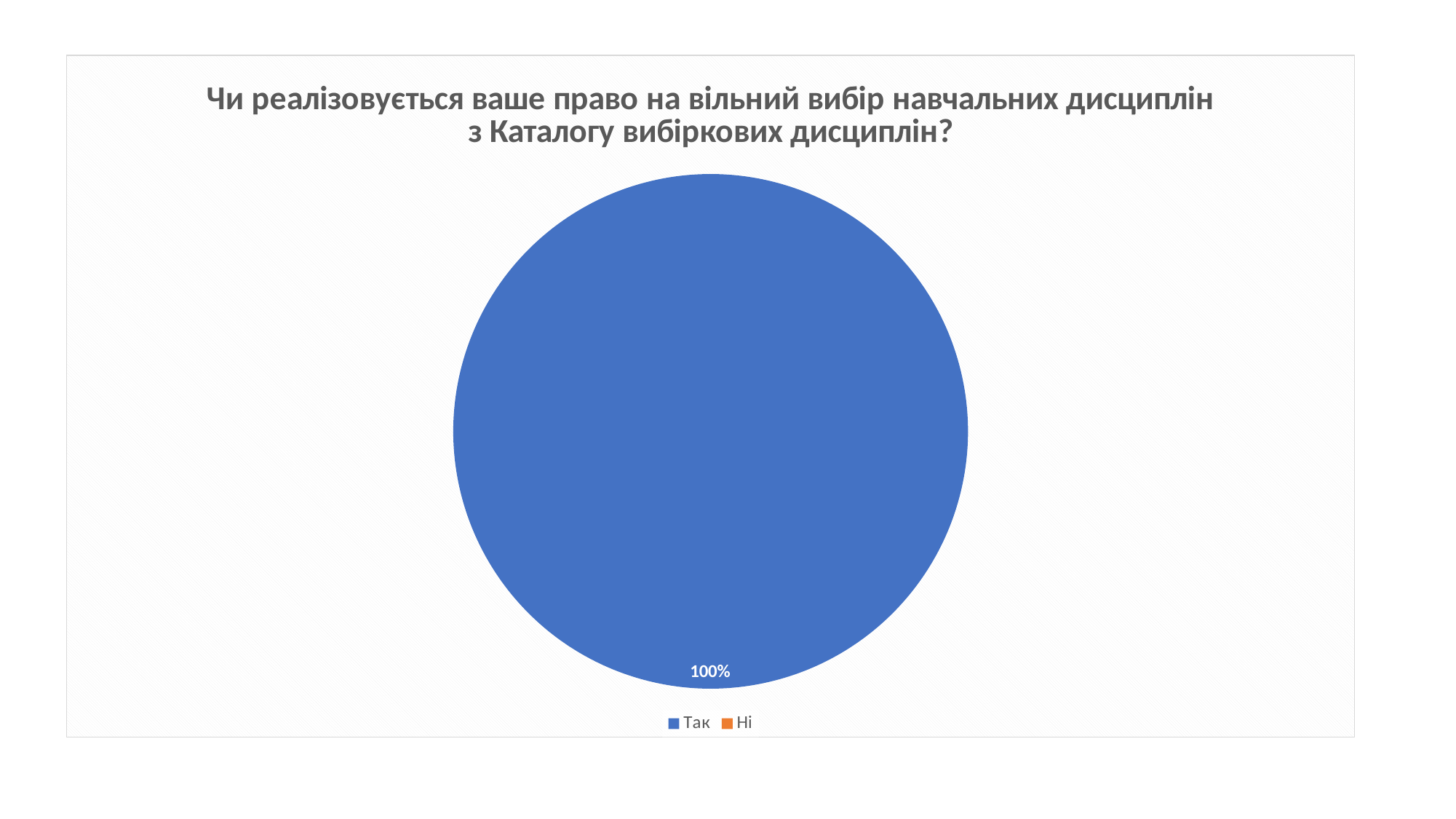
What is the title of the chart? Чи реалізовується ваше право на вільний вибір навчальних дисциплін з Каталогу вибіркових дисциплін? Which is larger, the share for "Так" or the share for "Ні"? Так Which category has the largest share of the pie? Так What percentage is shown for the "Так" slice? 100% What share of the pie does the "Так" slice take? 100% What kind of chart is shown on the slide? pie chart What colour represents "Так" in the legend? blue How many entries does the legend list? 2